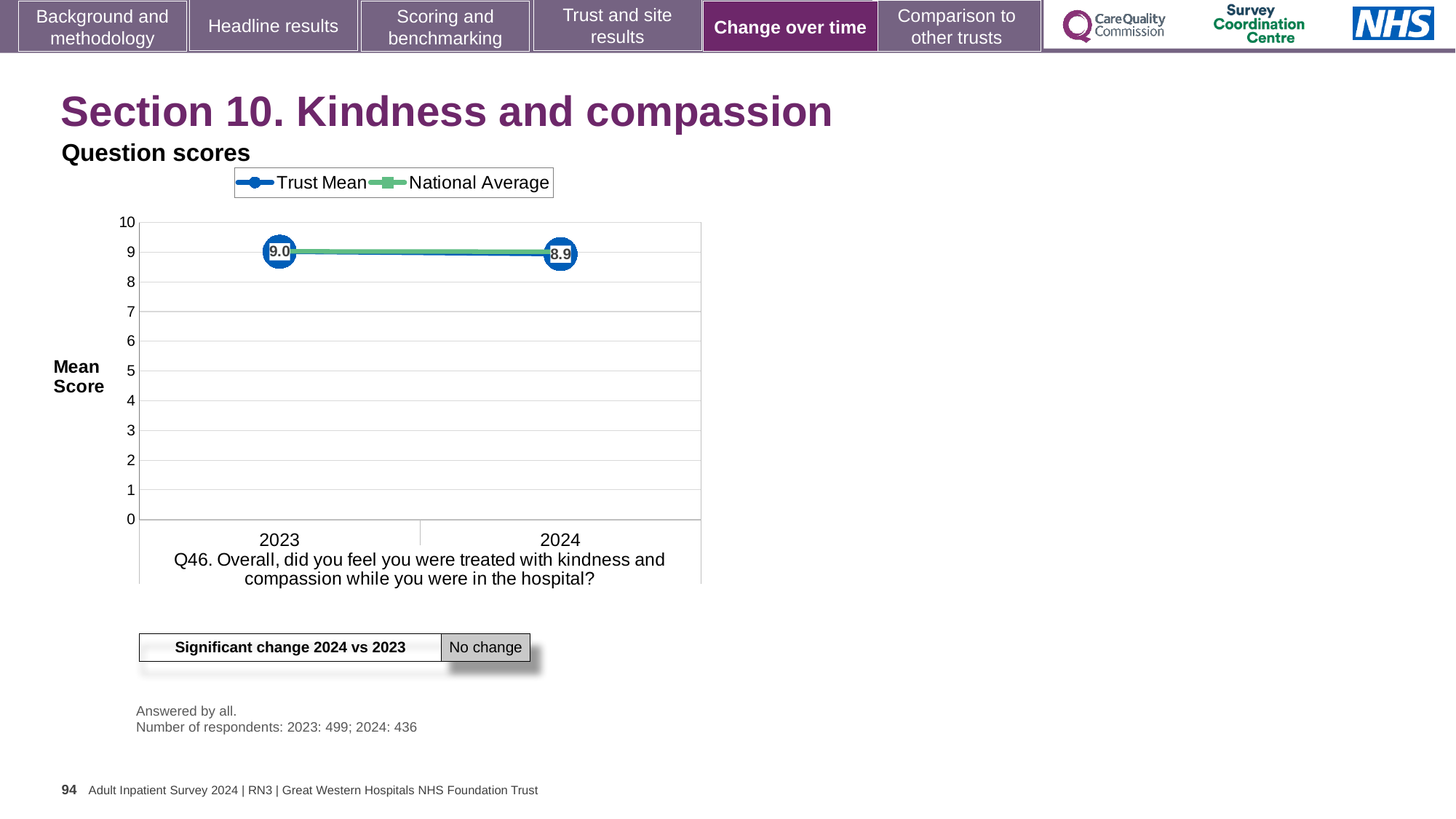
How many series does the legend list? 2 What is the Trust Mean score for 2024? 8.9 Is the Trust Mean score for 2024 greater or less than 8? greater Does the Trust Mean rise or fall from 2023 to 2024? fall What is the label on the y axis of the chart? Mean Score What are the two series named in the legend? Trust Mean and National Average What is the difference between the Trust Mean scores for 2023 and 2024? 0.1 What kind of chart is shown? line chart What is the Trust Mean score for 2023? 9.0 Which year has the higher Trust Mean score, 2023 or 2024? 2023 How many years are plotted on the x axis? 2 Is the Trust Mean score for 2023 greater or less than 10? less